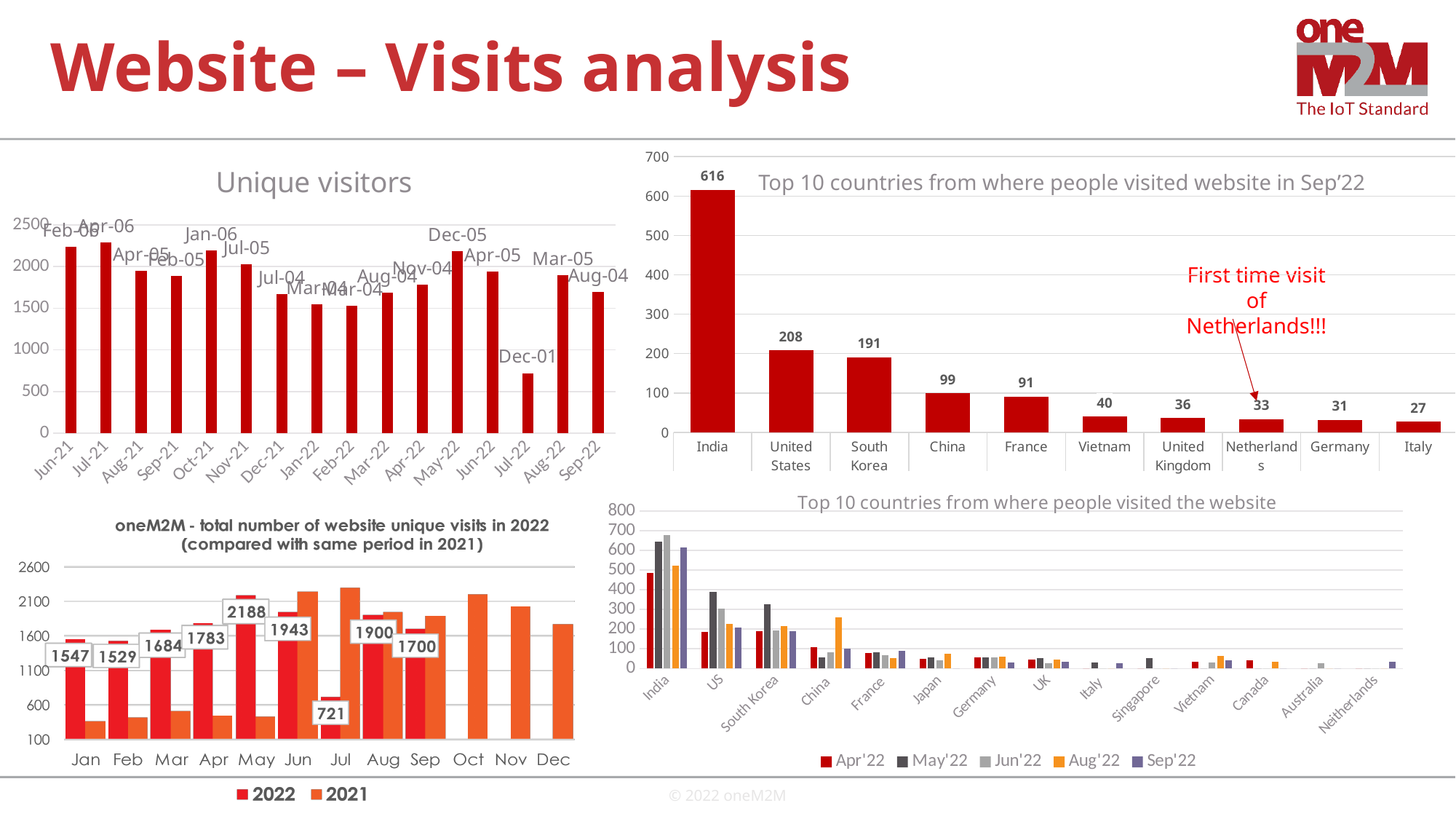
In the 'oneM2M - total number of website unique visits in 2022' chart, what is the 2022 value for July? 721 In the 'Top 10 countries from where people visited website in Sep'22' chart, which country has the lowest value? Italy In the 'Unique visitors' chart, which month has the lowest bar? Jul-22 In the 'Top 10 countries from where people visited website in Sep'22' chart, how many countries are shown? 10 In the 'Top 10 countries from where people visited website in Sep'22' chart, how many visits came from India? 616 In the 'Top 10 countries from where people visited the website' chart at the bottom right, how many series does the legend list? 5 In the 'oneM2M - total number of website unique visits in 2022' chart, how many series does the legend list? 2 In the 'Top 10 countries from where people visited website in Sep'22' chart, what is the difference between South Korea and China? 92 In the 'oneM2M - total number of website unique visits in 2022' chart, what is the difference between the 2022 values for Jun and Sep? 243 In the 'oneM2M - total number of website unique visits in 2022' chart, which is larger: the 2022 value for Jan or for Feb? Jan In the 'oneM2M - total number of website unique visits in 2022' chart, what is the 2022 value for May? 2188 In the 'Top 10 countries from where people visited website in Sep'22' chart, what is the value for the United States? 208